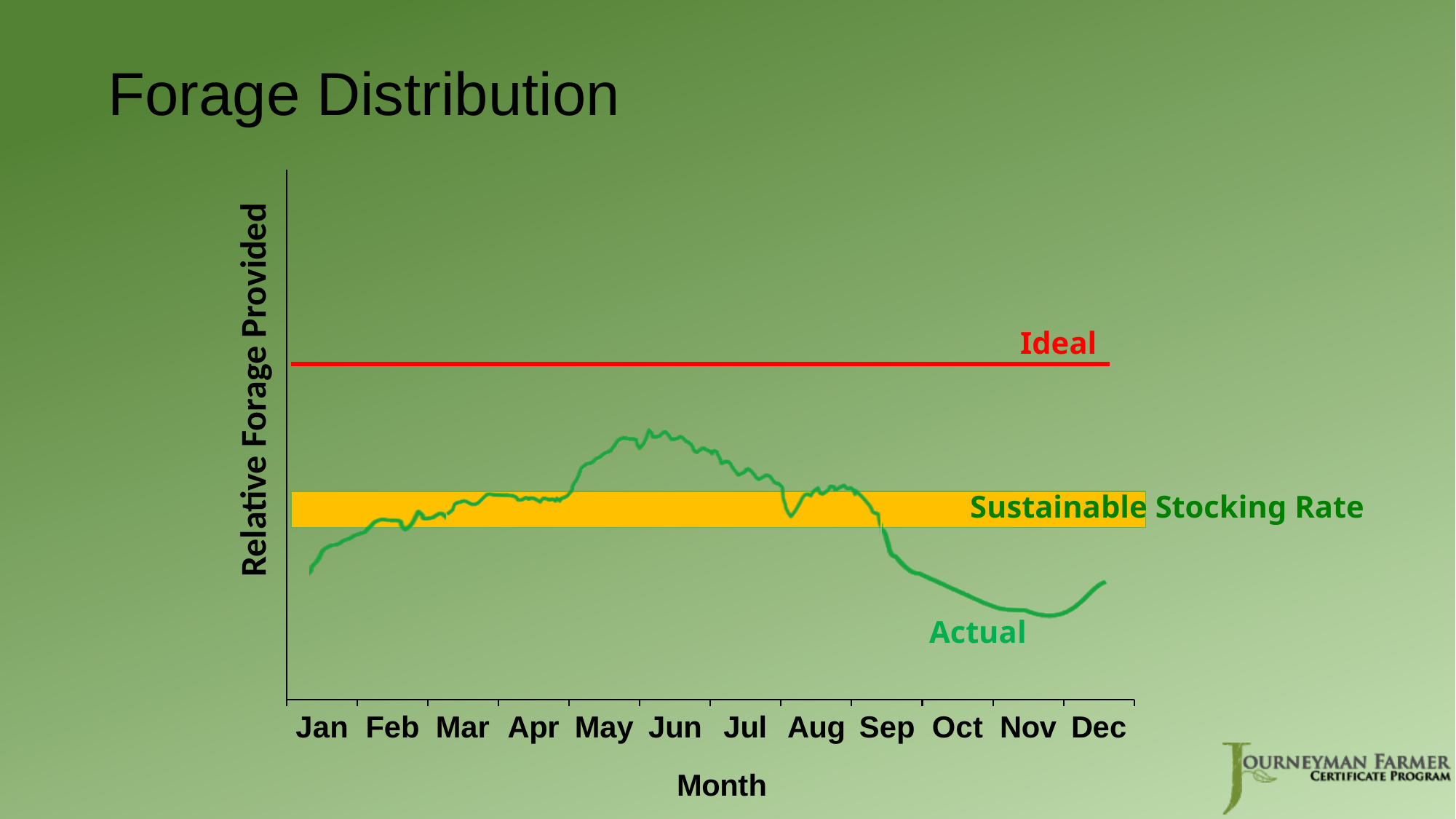
Does the Actual forage line rise or fall from Jan to Jun? Rise What is the label of the y axis? Relative Forage Provided What kind of chart is shown on the slide? Line chart In which month does the Actual forage line reach its lowest point? Nov What is the title of the slide? Forage Distribution Does the Actual forage line rise or fall from Aug to Nov? Fall In which month does the Actual forage line reach its highest point? Jun How many months are labelled along the x axis? 12 Is the Actual forage line above or below the Ideal line in Jun? Below Is the Actual forage value higher in Apr or in Oct? Apr Is the Actual forage value higher in Jun or in Nov? Jun